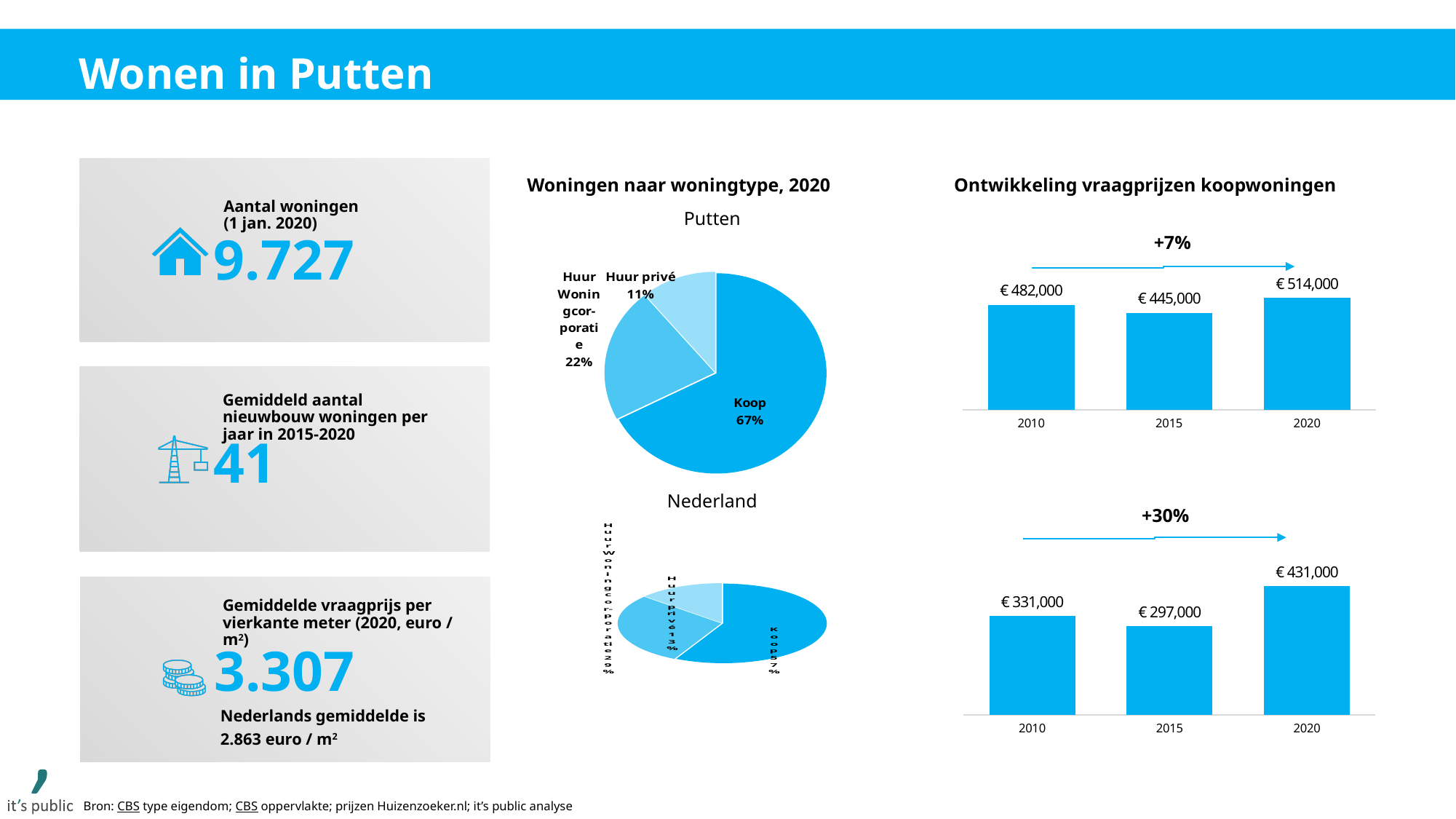
How many slices does the Putten pie chart have? 3 In the Putten pie chart, which category has the largest slice? Koop In the Putten pie chart, what share is Huur privé? 11% In the Putten pie chart under 'Woningen naar woningtype, 2020', what share is Koop? 67% In the upper bar chart under 'Ontwikkeling vraagprijzen koopwoningen', which year has the lowest value? 2015 In the lower bar chart under 'Ontwikkeling vraagprijzen koopwoningen', which year has the highest value? 2020 In the upper bar chart under 'Ontwikkeling vraagprijzen koopwoningen', what is the value for 2020? € 514,000 In the Putten pie chart, which category has the smallest slice? Huur privé In the upper bar chart under 'Ontwikkeling vraagprijzen koopwoningen', what is the difference between the 2020 and 2010 values? € 32,000 What percentage change is shown above the lower bar chart under 'Ontwikkeling vraagprijzen koopwoningen'? +30% In the lower bar chart under 'Ontwikkeling vraagprijzen koopwoningen', what is the value for 2015? € 297,000 In the Putten pie chart, what share is Huur Woningcorporatie? 22%